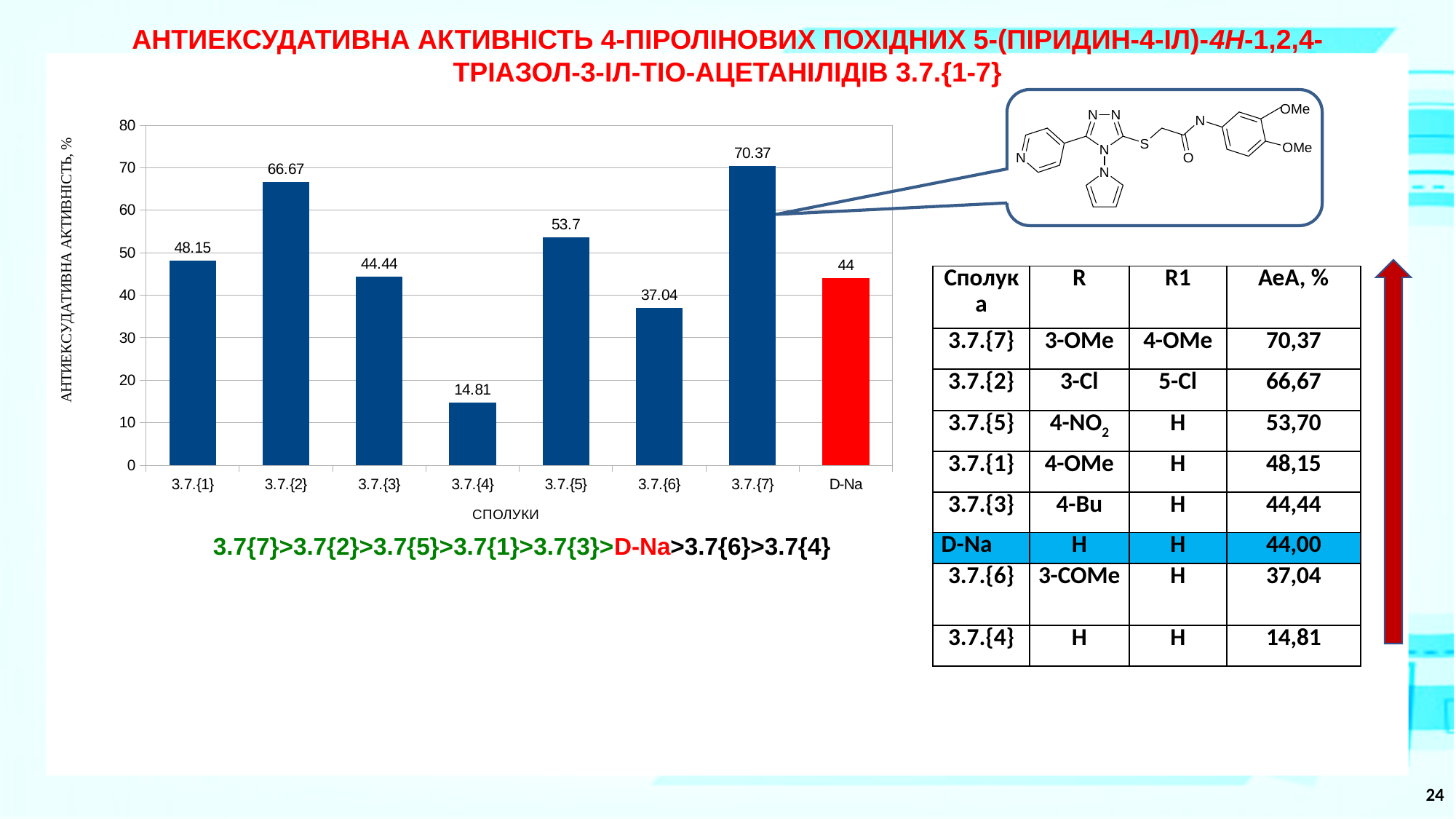
Is the value for 3.7.{6} in the bar chart greater or less than 40? less Which category has the lowest value in the bar chart? 3.7.{4} What is the value for 3.7.{7} in the bar chart? 70.37 What is the value for 3.7.{5} in the bar chart? 53.7 What is the value for D-Na in the bar chart? 44 What is the difference between the values for 3.7.{2} and 3.7.{6} in the bar chart? 29.63 How many categories are shown on the x axis of the bar chart? 8 Which bar in the chart is coloured red? D-Na Which is larger in the bar chart, the value for 3.7.{1} or the value for 3.7.{3}? 3.7.{1} Which category has the highest value in the bar chart? 3.7.{7} What is the value for 3.7.{4} in the bar chart? 14.81 What kind of chart is shown on the slide? bar chart